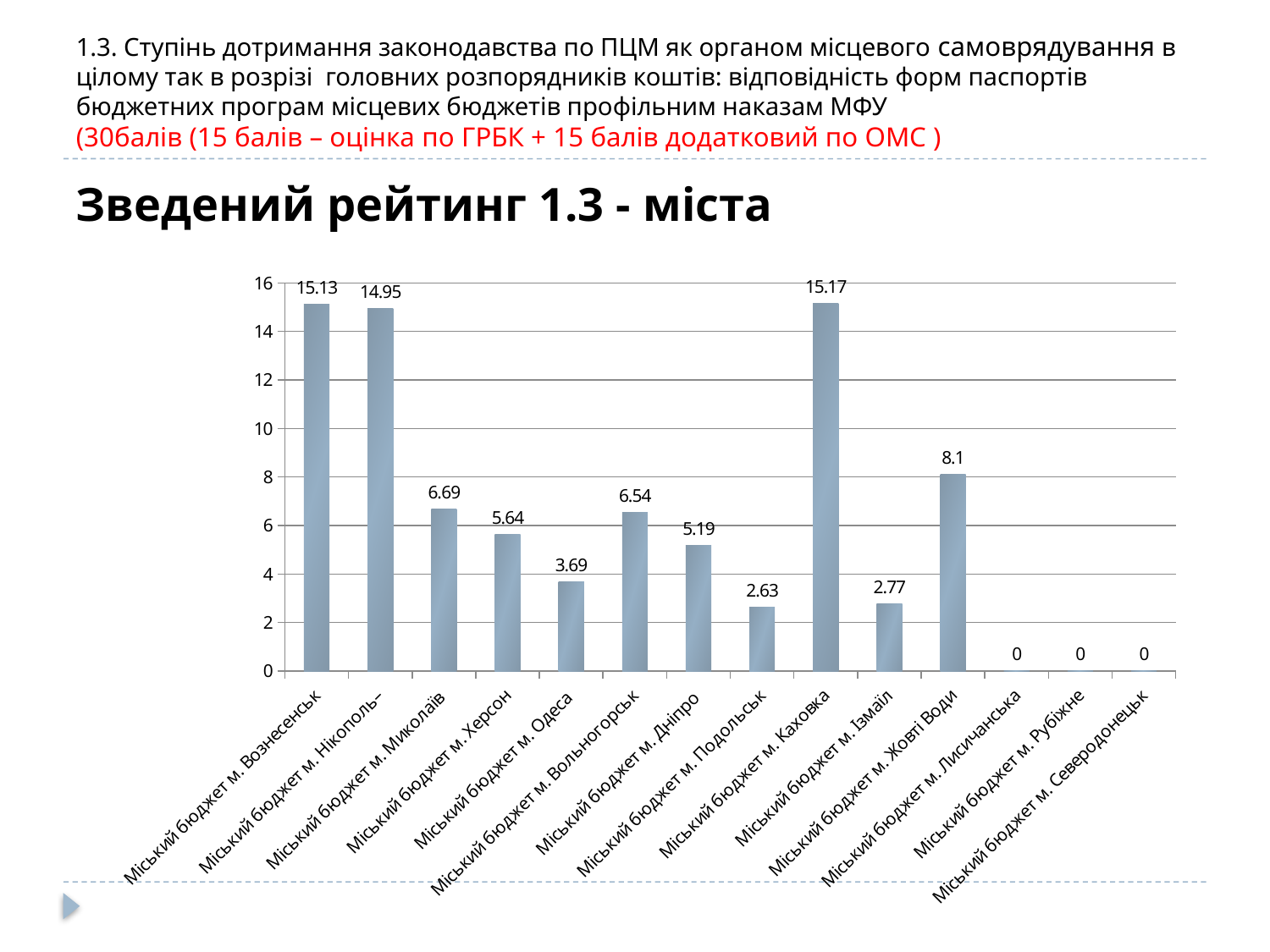
How many categories have a value of 0? 3 Which category has the highest value? Міський бюджет м. Каховка What is the value for Міський бюджет м. Одеса? 3.69 Is the value for Міський бюджет м. Ізмаїл greater or less than 4? less What is the value for Міський бюджет м. Жовті Води? 8.1 What kind of chart is shown on the slide? bar chart Which is larger, the value for Міський бюджет м. Херсон or Міський бюджет м. Дніпро? Міський бюджет м. Херсон What is the value for Міський бюджет м. Подольськ? 2.63 How many categories are shown on the x axis? 14 What is the title of the chart? Зведений рейтинг 1.3 - міста What is the difference between the values for Міський бюджет м. Жовті Води and Міський бюджет м. Миколаїв? 1.41 What is the value for Міський бюджет м. Каховка? 15.17